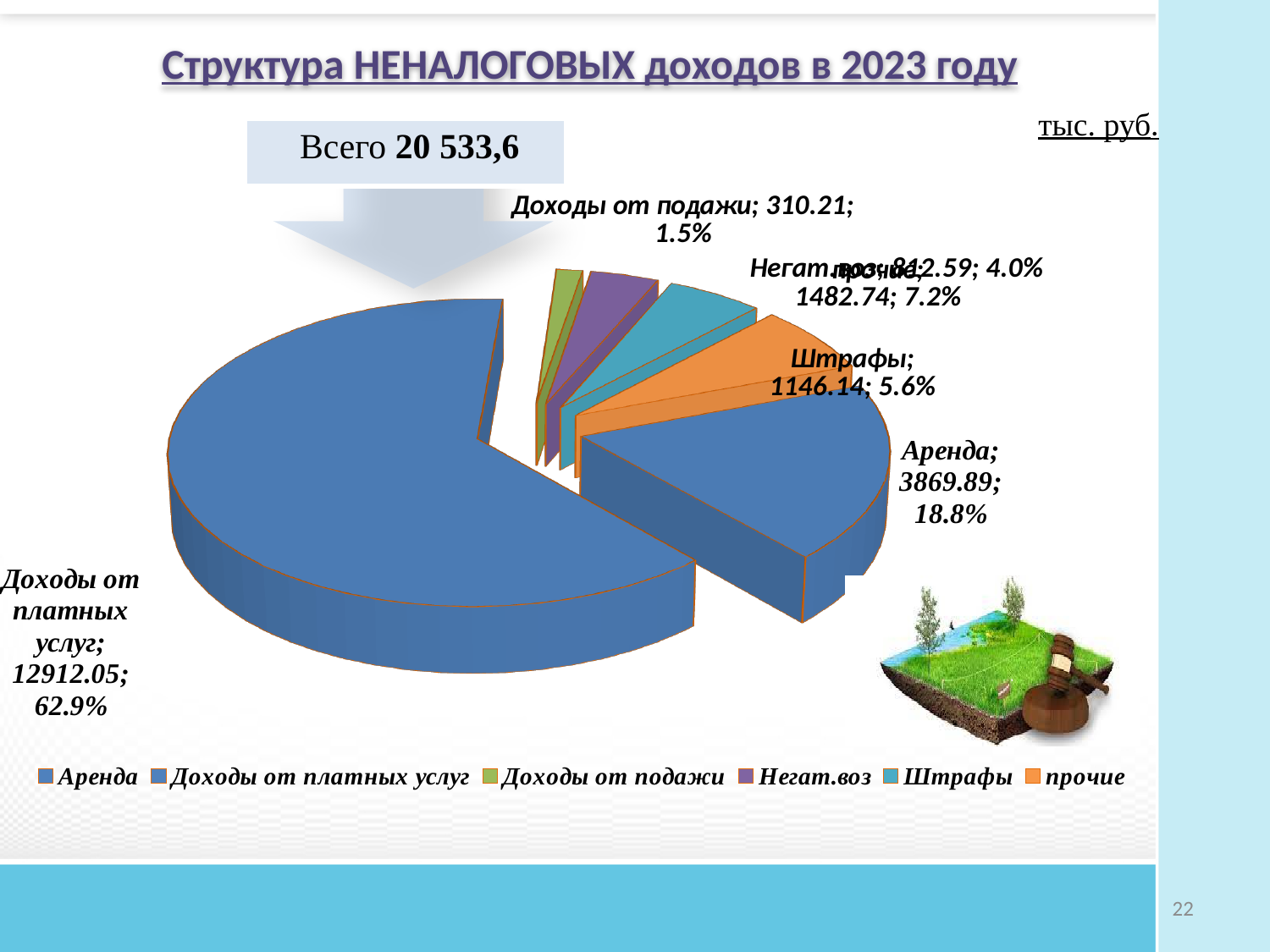
What total (Всего) is shown above the pie chart? 20 533,6 What is the value shown for Аренда in the pie chart? 3869.89 What share of the pie does Доходы от платных услуг represent? 62.9% What is the value shown for Штрафы in the pie chart? 1146.14 Which category has the smallest slice in the pie chart? Доходы от подажи How many categories does the legend of the pie chart list? 6 What is the value shown for Доходы от подажи in the pie chart? 310.21 Which is larger in the pie chart, Аренда or Штрафы? Аренда What share of the pie does Штрафы represent? 5.6% Which category has the largest slice in the pie chart? Доходы от платных услуг What kind of chart is shown on the slide? pie chart What is the difference between the values for Аренда and Штрафы? 2723.75